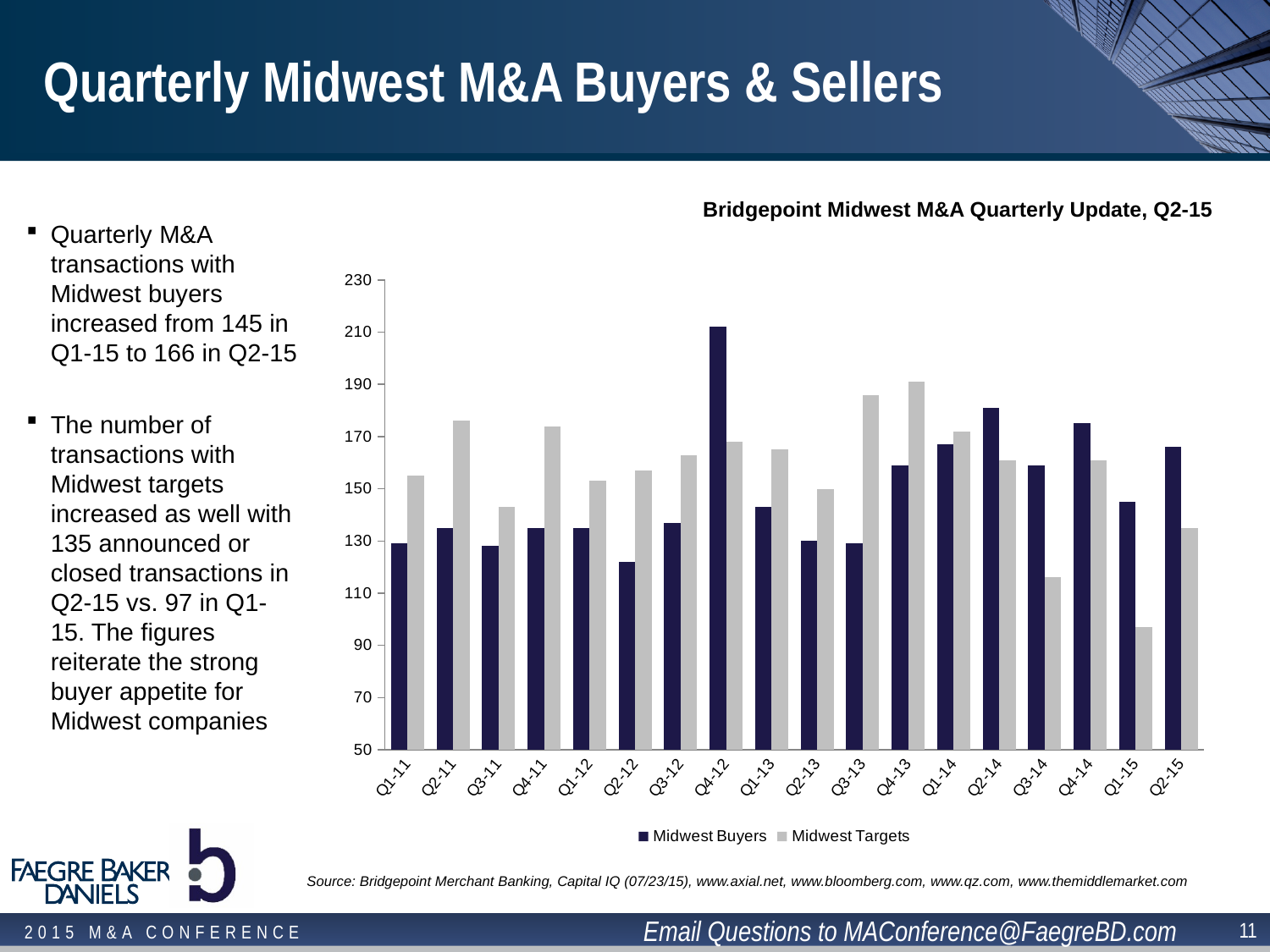
In which quarter is the Midwest Buyers value highest? Q4-12 Is the Midwest Buyers value for Q4-12 greater or less than 190? greater What is the title of the chart? Bridgepoint Midwest M&A Quarterly Update, Q2-15 In Q4-12, which is larger: Midwest Buyers or Midwest Targets? Midwest Buyers How many series does the chart legend list? 2 What kind of chart is shown on the slide? bar chart Is the Midwest Targets value for Q3-14 greater or less than 130? less In which quarter is the Midwest Targets value lowest? Q1-15 According to the slide, what is the number of Midwest Buyers transactions in Q2-15? 166 In Q2-11, which is larger: Midwest Buyers or Midwest Targets? Midwest Targets According to the slide, by how much did Midwest Targets transactions increase from Q1-15 to Q2-15? 38 How many quarters are shown on the x axis of the chart? 18